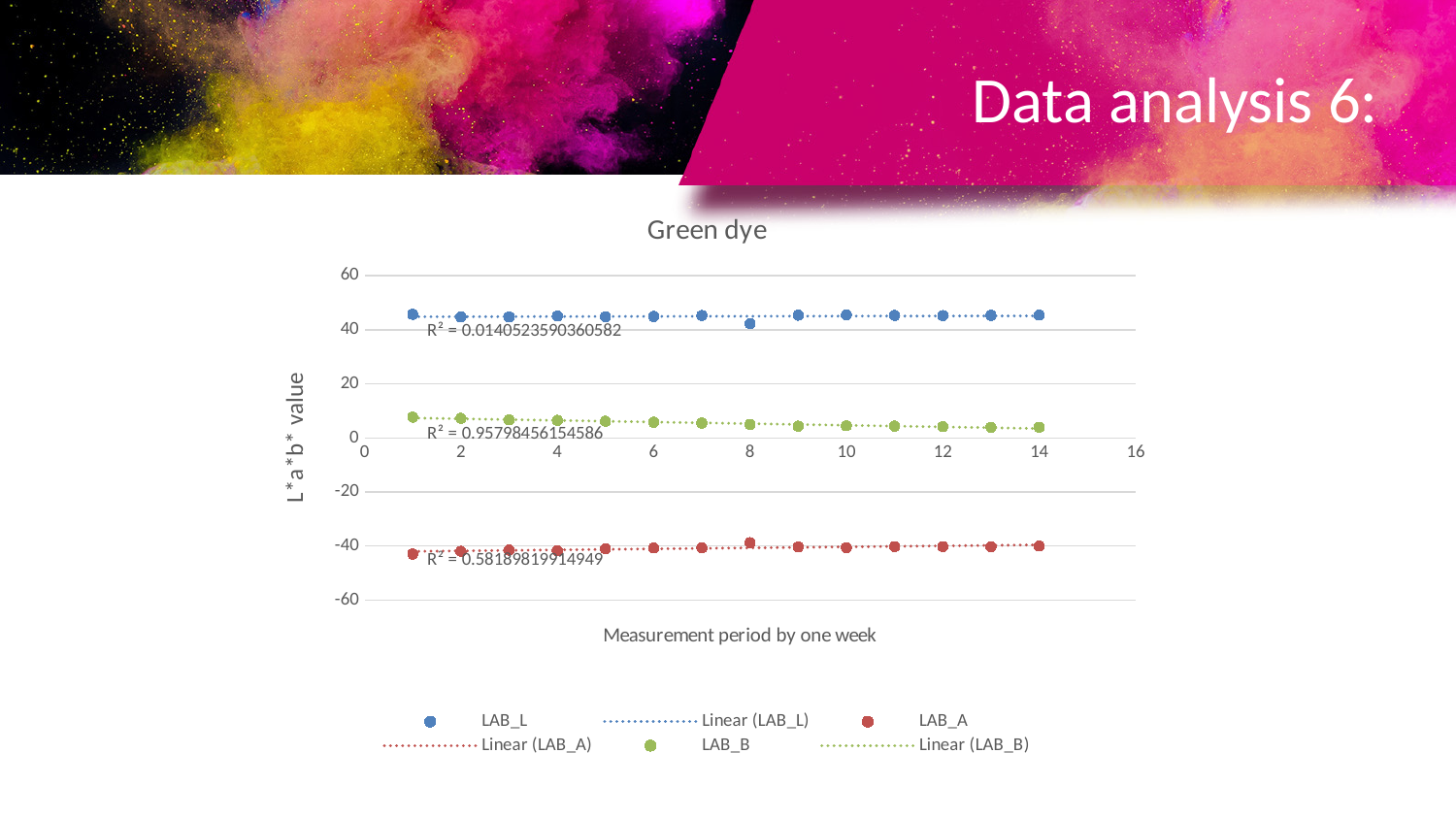
What is the R² value printed for the LAB_B trendline? 0.95798456154586 Which series has the lowest values on the chart? LAB_A Is the value for LAB_L at week 1 greater or less than 40? greater How many entries does the chart legend list? 6 Which series has the highest values on the chart? LAB_L What type of chart is shown on the slide? scatter chart Do the LAB_B values rise or fall from week 1 to week 14? fall What is the title of the chart? Green dye Is the value for LAB_B at week 14 greater or less than 20? less Is the value for LAB_A at week 1 greater or less than -20? less Which is larger at week 8, the value for LAB_L or the value for LAB_B? LAB_L How many data points are plotted for the LAB_L series? 14